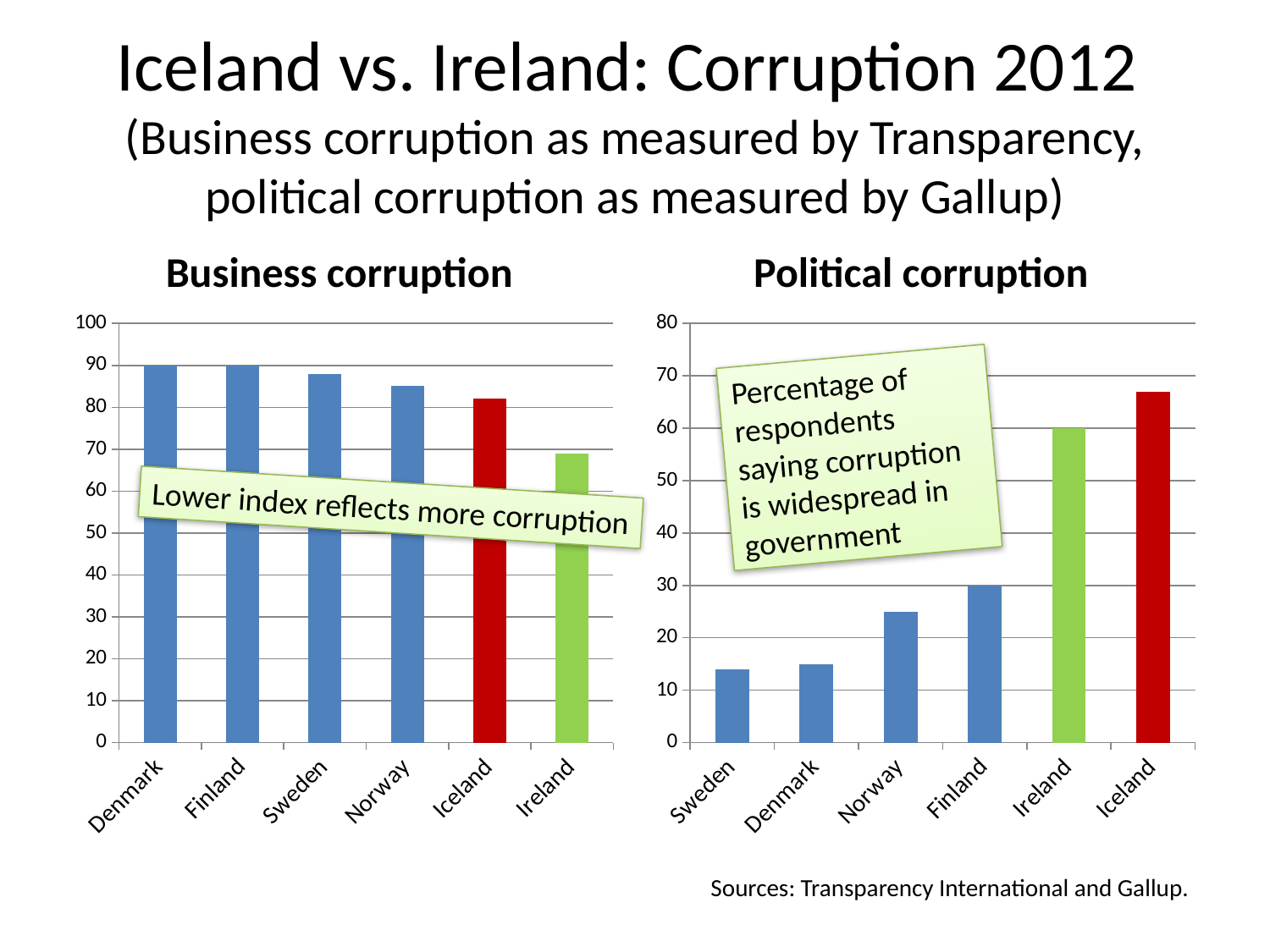
In the Business corruption chart, which country has the lowest value? Ireland In the Business corruption chart, what is the value for Denmark? 90 In the Political corruption chart, is the value for Norway greater or less than 20? greater In the Political corruption chart, which is larger, the value for Iceland or the value for Ireland? Iceland In the Political corruption chart, do the values rise or fall from left to right along the x axis? rise In the Business corruption chart, which is larger, the value for Norway or the value for Iceland? Norway In the Political corruption chart, what is the value for Ireland? 60 How many countries are shown in the Political corruption chart? 6 In the Political corruption chart, what is the value for Finland? 30 What kind of chart is the Business corruption chart? bar chart In the Political corruption chart, which country has the highest value? Iceland